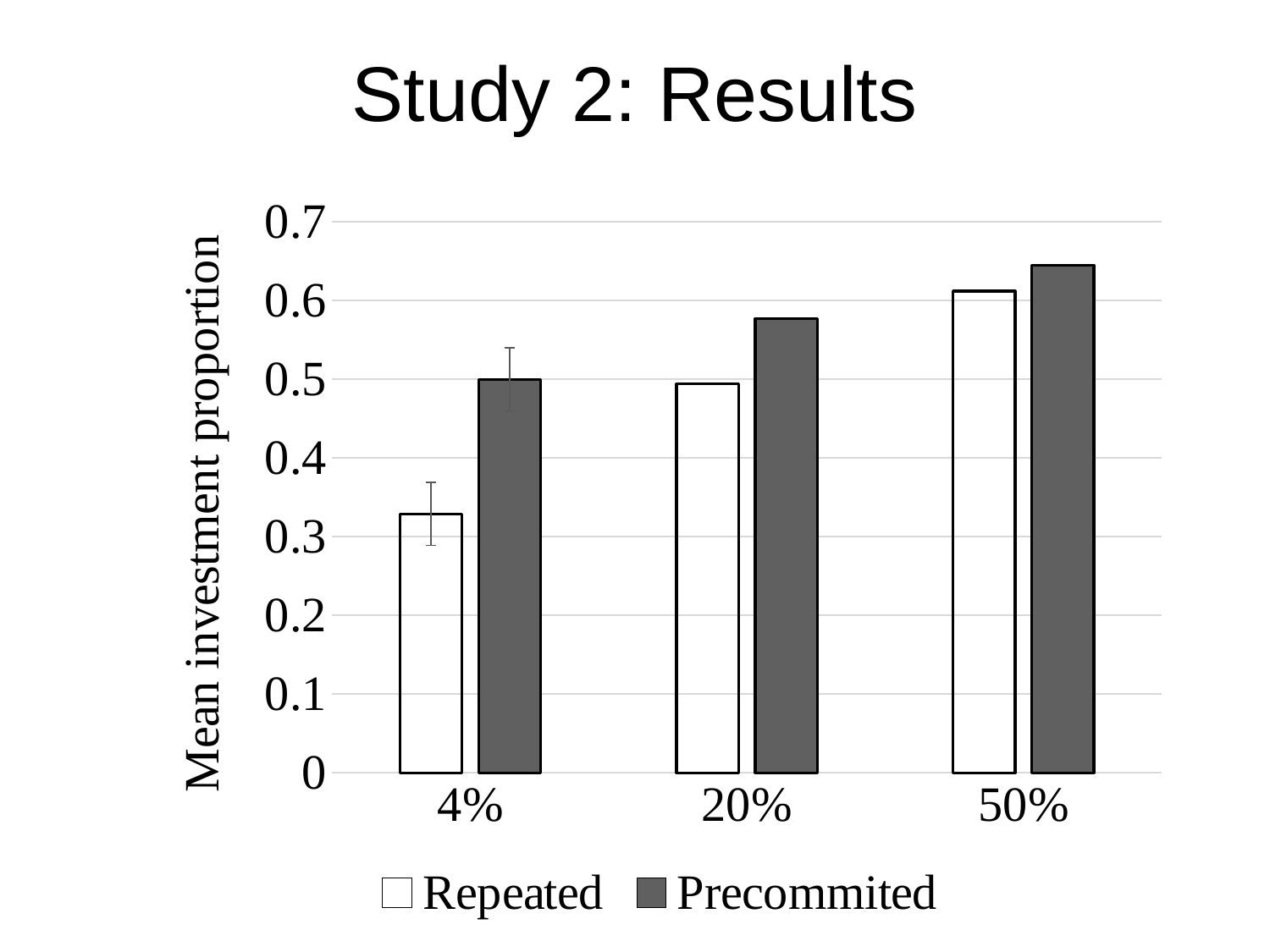
Is the Repeated value for 50% greater or less than 0.6? greater How many series does the legend list? 2 For the 4% category, which series has the larger value, Repeated or Precommited? Precommited Is the Precommited value for 20% greater or less than 0.5? greater Which category has the lowest Repeated value? 4% What is the label of the y axis? Mean investment proportion Is the Repeated value for 4% greater or less than 0.4? less Which category has the highest Precommited value? 50% What kind of chart is shown on the slide? bar chart Do the Repeated values rise or fall as the x axis goes from 4% to 50%? rise How many categories are shown on the x axis? 3